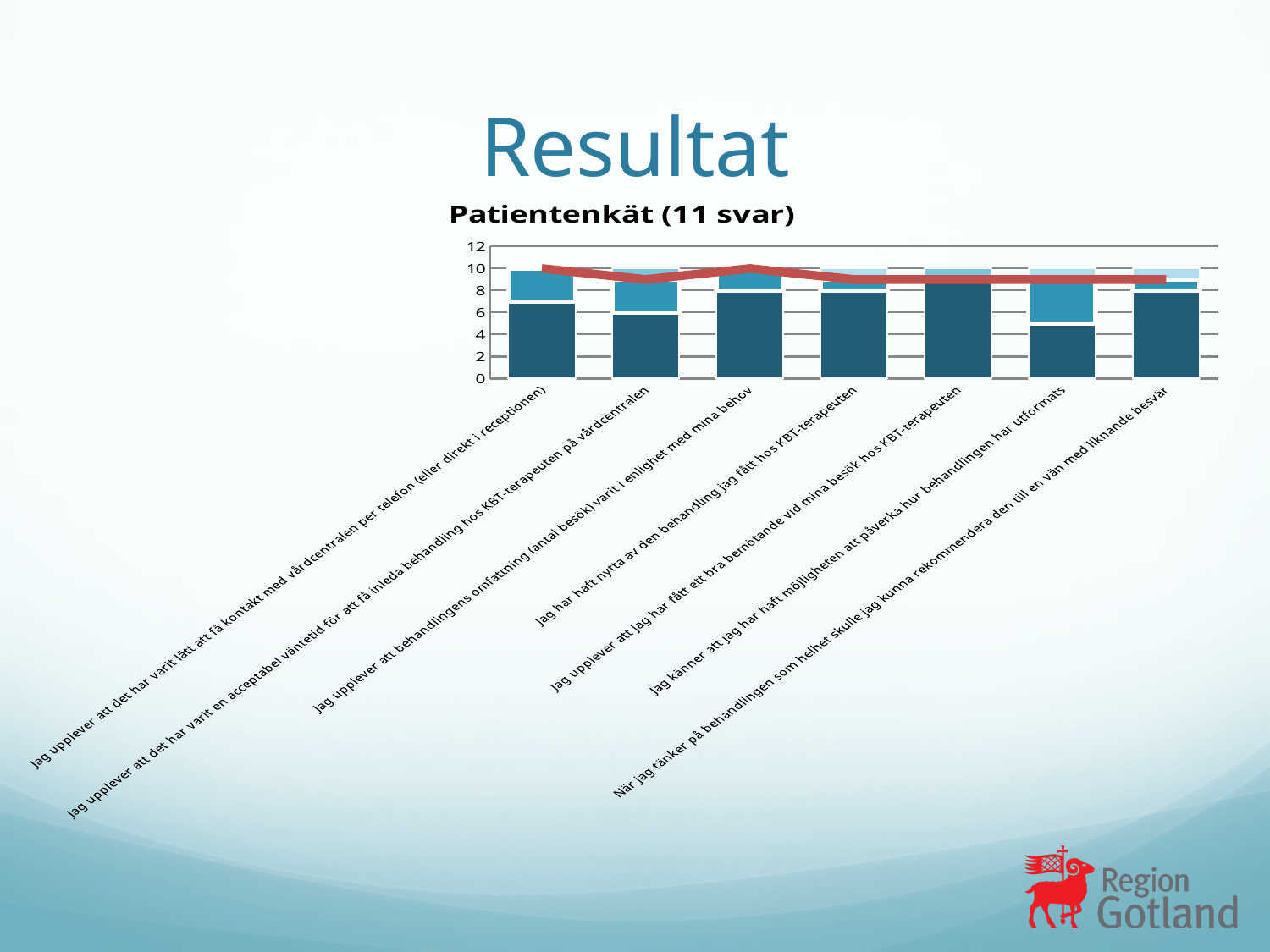
What is the highest value shown on the y axis of the chart? 12 Is the dark blue bottom segment for "Jag upplever att det har varit lätt att få kontakt med vårdcentralen per telefon (eller direkt i receptionen)" greater or less than 8? less Which has the larger dark blue bottom segment: "Jag upplever att det har varit lätt att få kontakt med vårdcentralen per telefon (eller direkt i receptionen)" or "Jag känner att jag har haft möjligheten att påverka hur behandlingen har utformats"? Jag upplever att det har varit lätt att få kontakt med vårdcentralen per telefon (eller direkt i receptionen) Is the dark blue bottom segment for "Jag upplever att jag har fått ett bra bemötande vid mina besök hos KBT-terapeuten" greater or less than 8? greater What kind of chart is shown on the slide? Stacked bar chart with a line Which category has the highest dark blue bottom segment? Jag upplever att jag har fått ett bra bemötande vid mina besök hos KBT-terapeuten Which category has the lowest dark blue bottom segment? Jag känner att jag har haft möjligheten att påverka hur behandlingen har utformats Is the red line value for "Jag upplever att behandlingens omfattning (antal besök) varit i enlighet med mina behov" greater or less than 8? greater What is the title of the chart? Patientenkät (11 svar) How many categories (statements) are shown on the x axis of the chart? 7